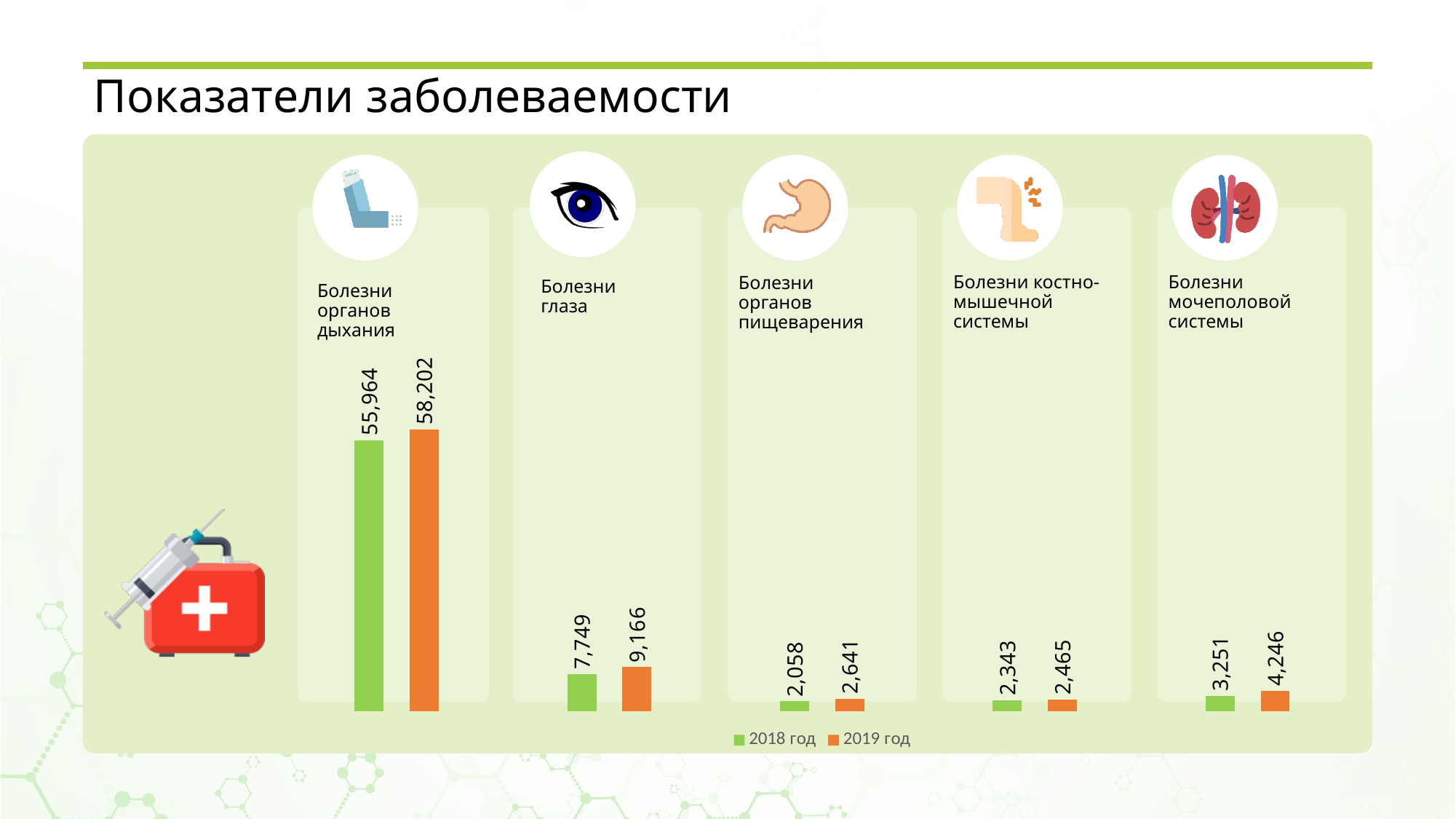
What is the 2018 год value for Болезни органов дыхания? 55,964 How many disease categories are shown in the chart? 5 What is the 2018 год value for Болезни костно-мышечной системы? 2,343 Which category has the highest 2019 год value? Болезни органов дыхания How many series does the legend list? 2 What is the 2019 год value for Болезни мочеполовой системы? 4,246 What is the difference between the 2019 год and 2018 год values for Болезни глаза? 1,417 What type of chart is shown on the slide? Bar chart Which category has the lowest 2018 год value? Болезни органов пищеварения What is the difference between the 2019 год and 2018 год values for Болезни органов дыхания? 2,238 Which is larger: the 2018 год value for Болезни мочеполовой системы or the 2019 год value for Болезни органов пищеварения? 2018 год value for Болезни мочеполовой системы What is the 2019 год value for Болезни глаза? 9,166